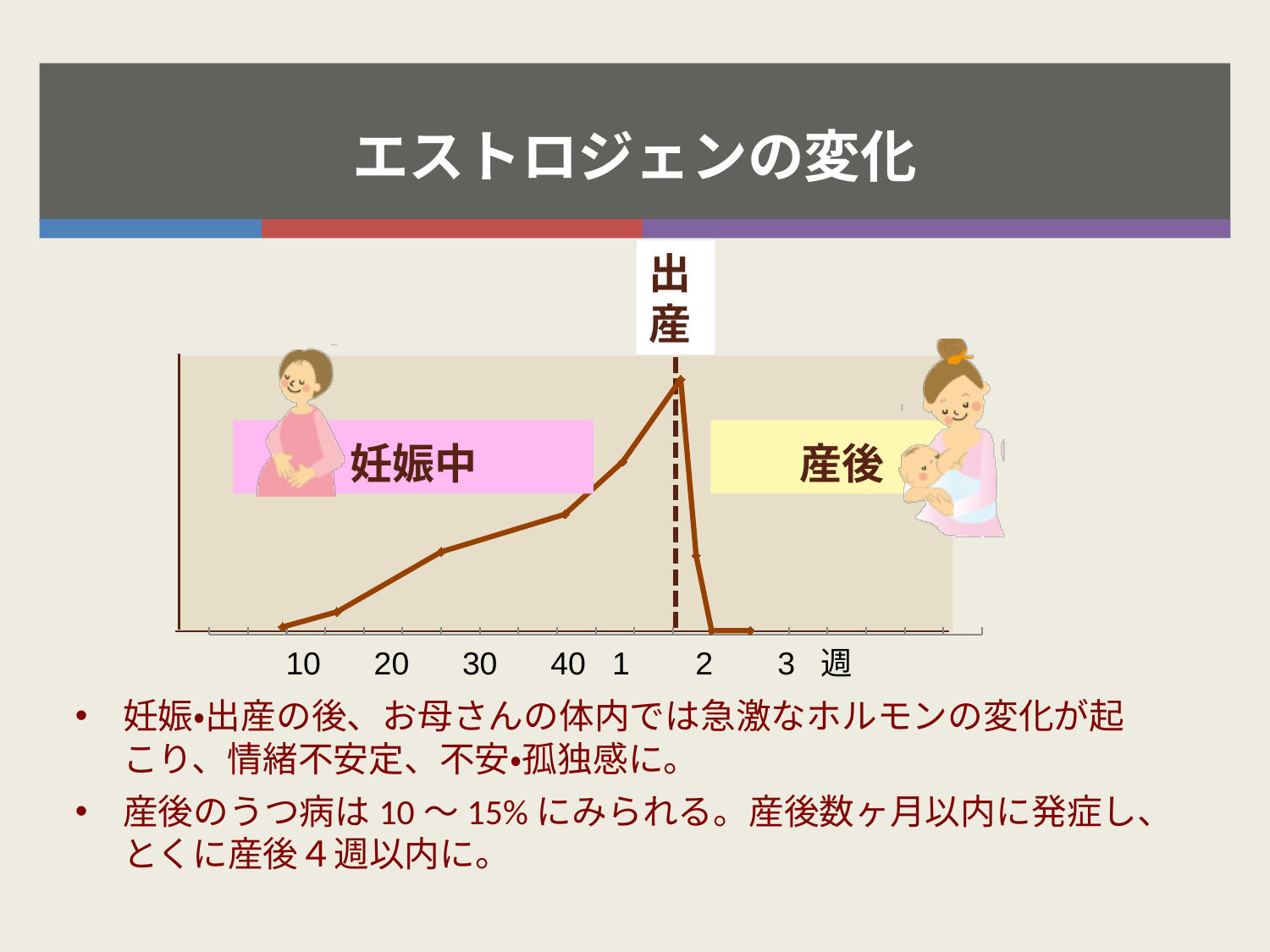
At which point on the x axis does the estrogen line reach its peak? 出産 How many data series are plotted in the chart? 1 What is the title of the slide/chart? エストロジェンの変化 Which is higher on the line, the value at week 40 or the value at week 10? week 40 Does the estrogen line rise or fall immediately after 出産 (birth)? fall Which is higher on the line, the value at week 30 or the value at week 3 (postpartum)? week 30 Does the estrogen line rise or fall across the 妊娠中 (pregnancy) period from week 10 to week 40? rise What kind of chart is shown on the slide? line chart What is the unit label shown at the end of the x axis? 週 What label is shown in the pink box on the left side of the chart? 妊娠中